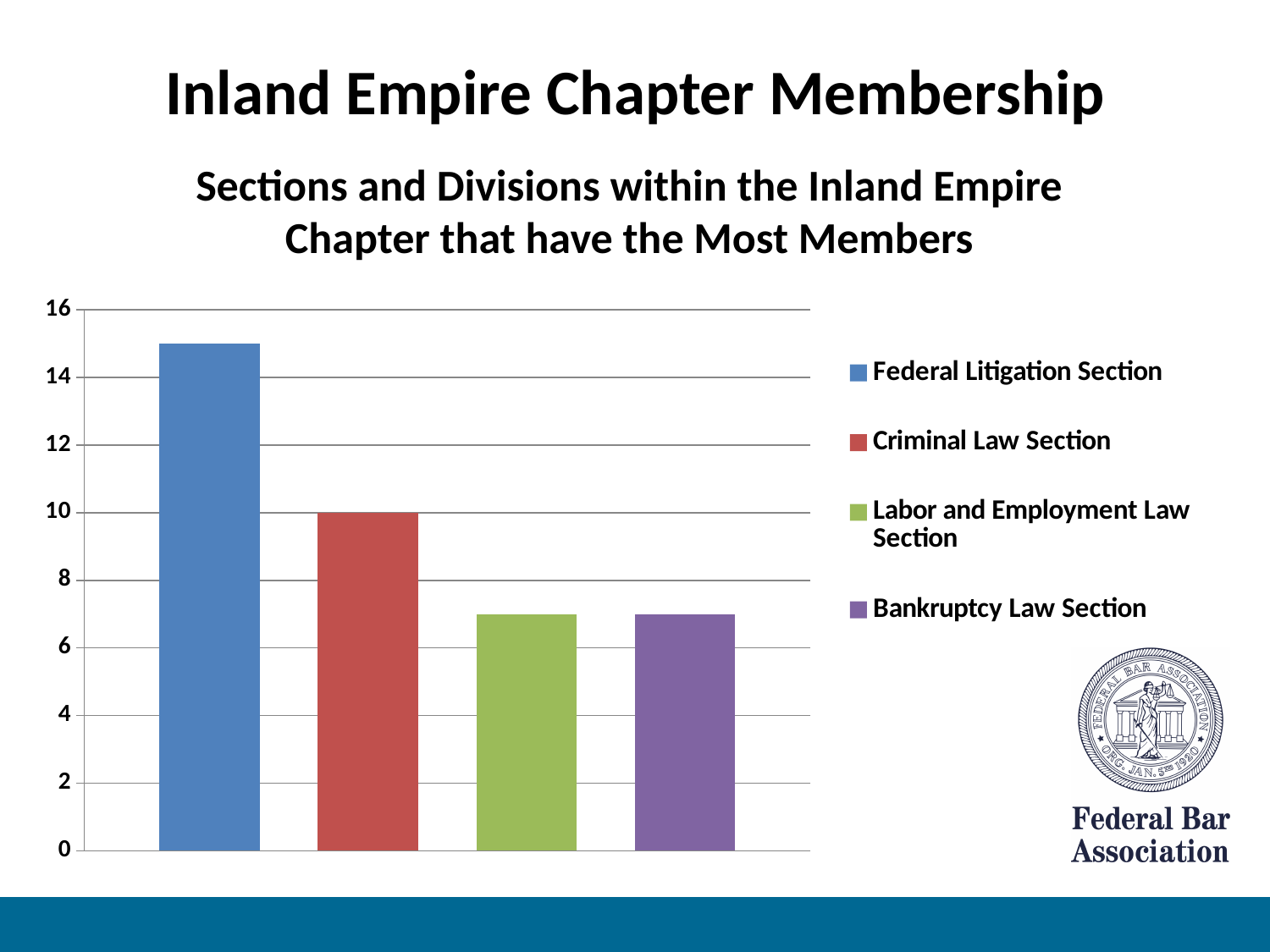
Which has more members, the Federal Litigation Section or the Criminal Law Section? Federal Litigation Section How many bars are plotted in the chart? 4 What is the value shown for the Criminal Law Section? 10 What type of chart is shown on the slide? bar chart Which section has the highest number of members in the chart? Federal Litigation Section How many entries does the chart's legend list? 4 Do the bar values rise or fall from left to right across the chart? fall Is the value for the Labor and Employment Law Section greater or less than 8? less Is the value for the Bankruptcy Law Section greater or less than 6? greater Which has more members, the Criminal Law Section or the Labor and Employment Law Section? Criminal Law Section What colour is the bar for the Bankruptcy Law Section? purple Is the value for the Federal Litigation Section greater or less than 14? greater